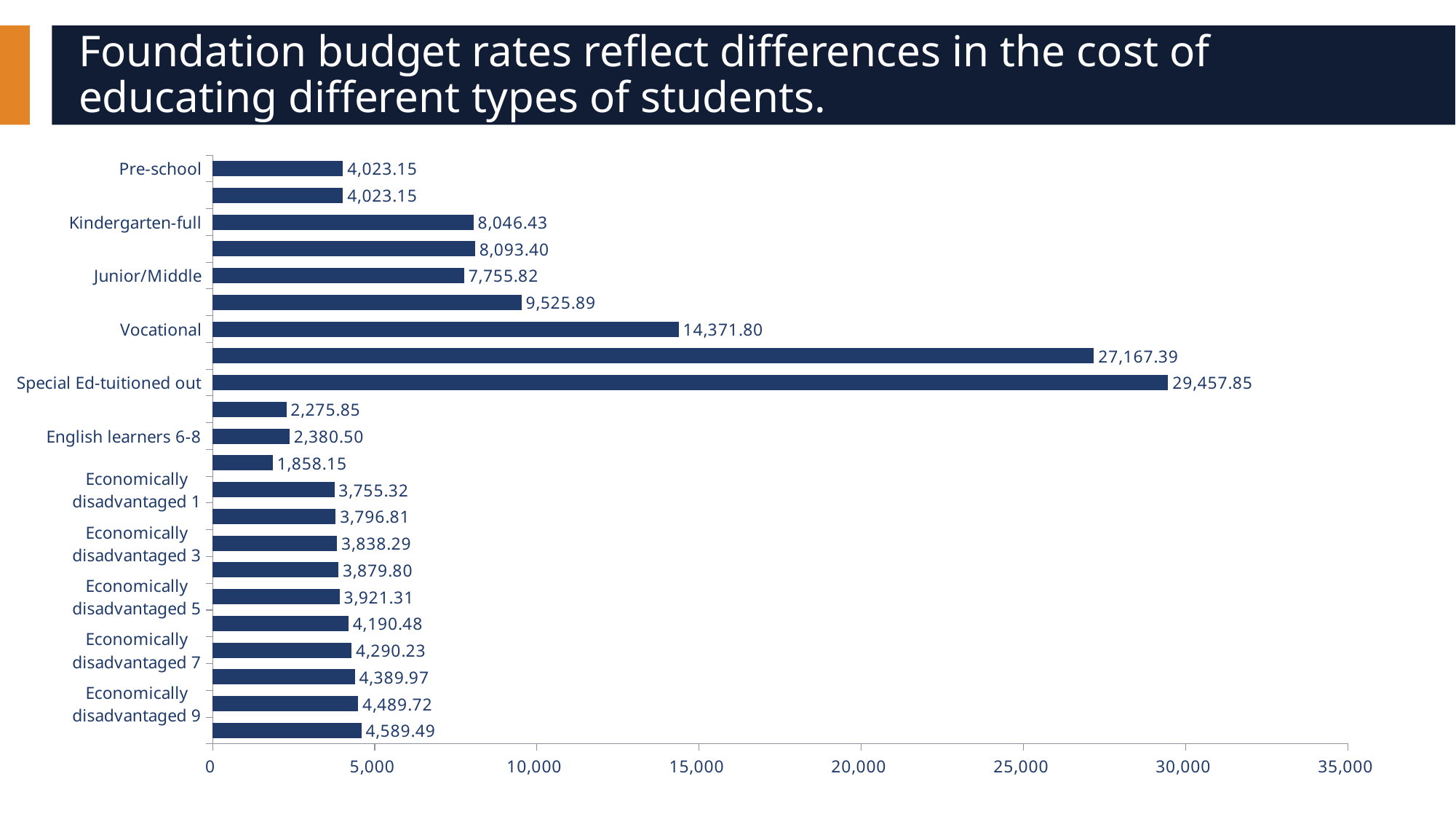
Is the value for Vocational greater or less than 10,000? greater How many bars are plotted on the chart? 22 What is the value for English learners 6-8? 2,380.50 What is the value for Vocational? 14,371.80 What is the difference between the values for Vocational and Junior/Middle? 6,615.98 What is the value for Economically disadvantaged 5? 3,921.31 What is the difference between the values for Kindergarten-full and Pre-school? 4,023.28 Which is larger, the value for Economically disadvantaged 9 or Economically disadvantaged 1? Economically disadvantaged 9 What kind of chart is shown on the slide? bar chart What is the smallest value shown on the chart? 1,858.15 Which labeled category has the highest value? Special Ed-tuitioned out What is the value for Special Ed-tuitioned out? 29,457.85